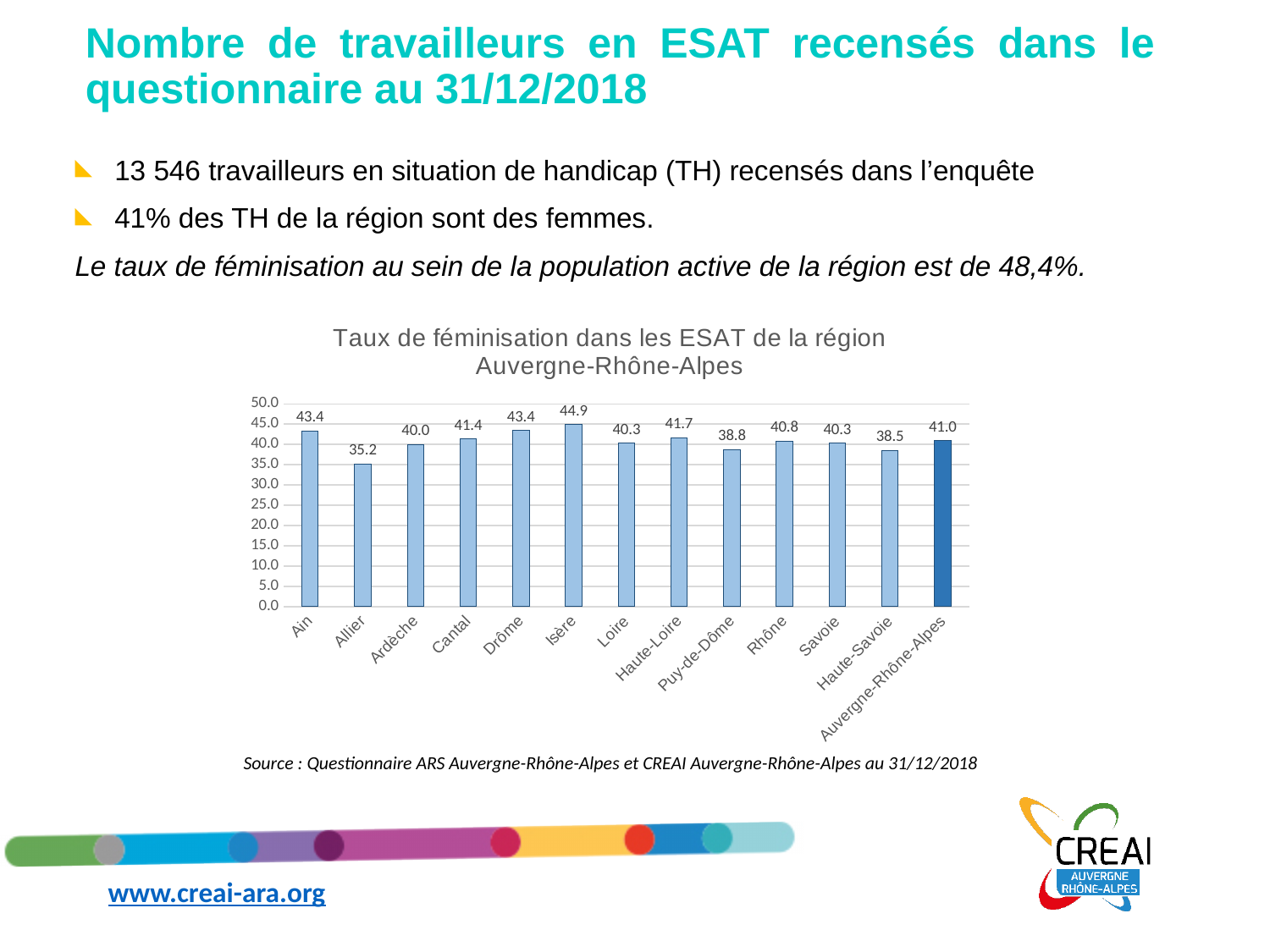
How many categories are shown on the x axis? 13 Which category has the lowest value? Allier What kind of chart is this? bar chart Which bar is shown in a darker blue than the others? Auvergne-Rhône-Alpes What is the difference between the values for Isère and Allier? 9.7 What is the value for Auvergne-Rhône-Alpes? 41.0 What is the value for Allier? 35.2 Which is larger, the value for Ain or the value for Puy-de-Dôme? Ain Which category has the highest value? Isère What is the title of the chart? Taux de féminisation dans les ESAT de la région Auvergne-Rhône-Alpes Is the value for Haute-Savoie greater or less than 40.0? less What is the value for Isère? 44.9